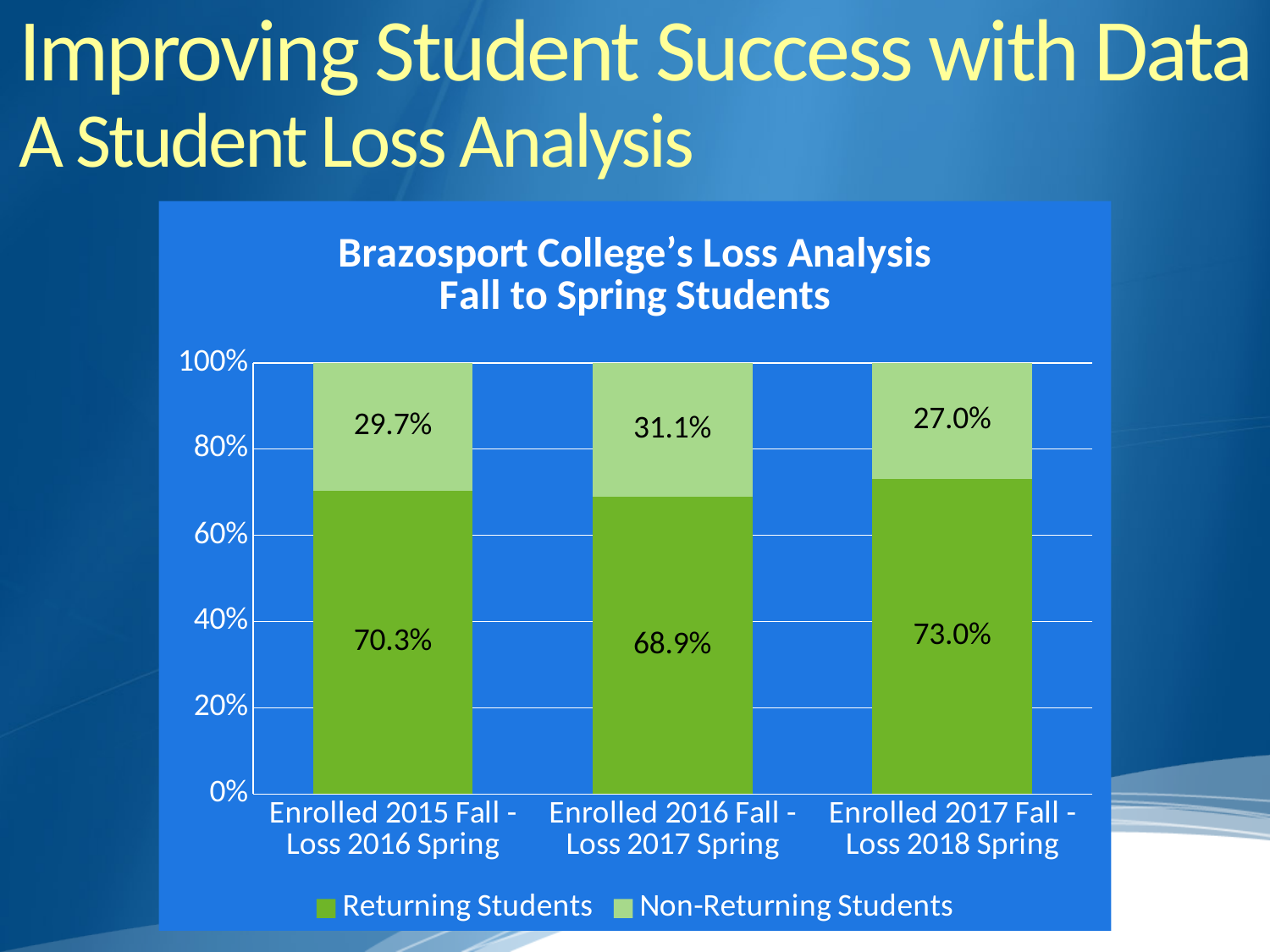
Which is larger: the Non-Returning Students percentage for Enrolled 2015 Fall - Loss 2016 Spring or for Enrolled 2016 Fall - Loss 2017 Spring? Enrolled 2016 Fall - Loss 2017 Spring How many series does the legend list? 2 How many categories are shown on the x axis? 3 What percentage of Returning Students is shown for Enrolled 2015 Fall - Loss 2016 Spring? 70.3% What percentage of Returning Students is shown for Enrolled 2017 Fall - Loss 2018 Spring? 73.0% Which category has the lowest percentage of Non-Returning Students? Enrolled 2017 Fall - Loss 2018 Spring Is the Returning Students value for Enrolled 2016 Fall - Loss 2017 Spring greater or less than 60%? greater What percentage of Non-Returning Students is shown for Enrolled 2016 Fall - Loss 2017 Spring? 31.1% What kind of chart is shown on the slide? Stacked bar chart What is the difference between the Returning Students percentages for Enrolled 2017 Fall - Loss 2018 Spring and Enrolled 2016 Fall - Loss 2017 Spring? 4.1% Which category has the highest percentage of Returning Students? Enrolled 2017 Fall - Loss 2018 Spring What is the title of the chart? Brazosport College's Loss Analysis Fall to Spring Students